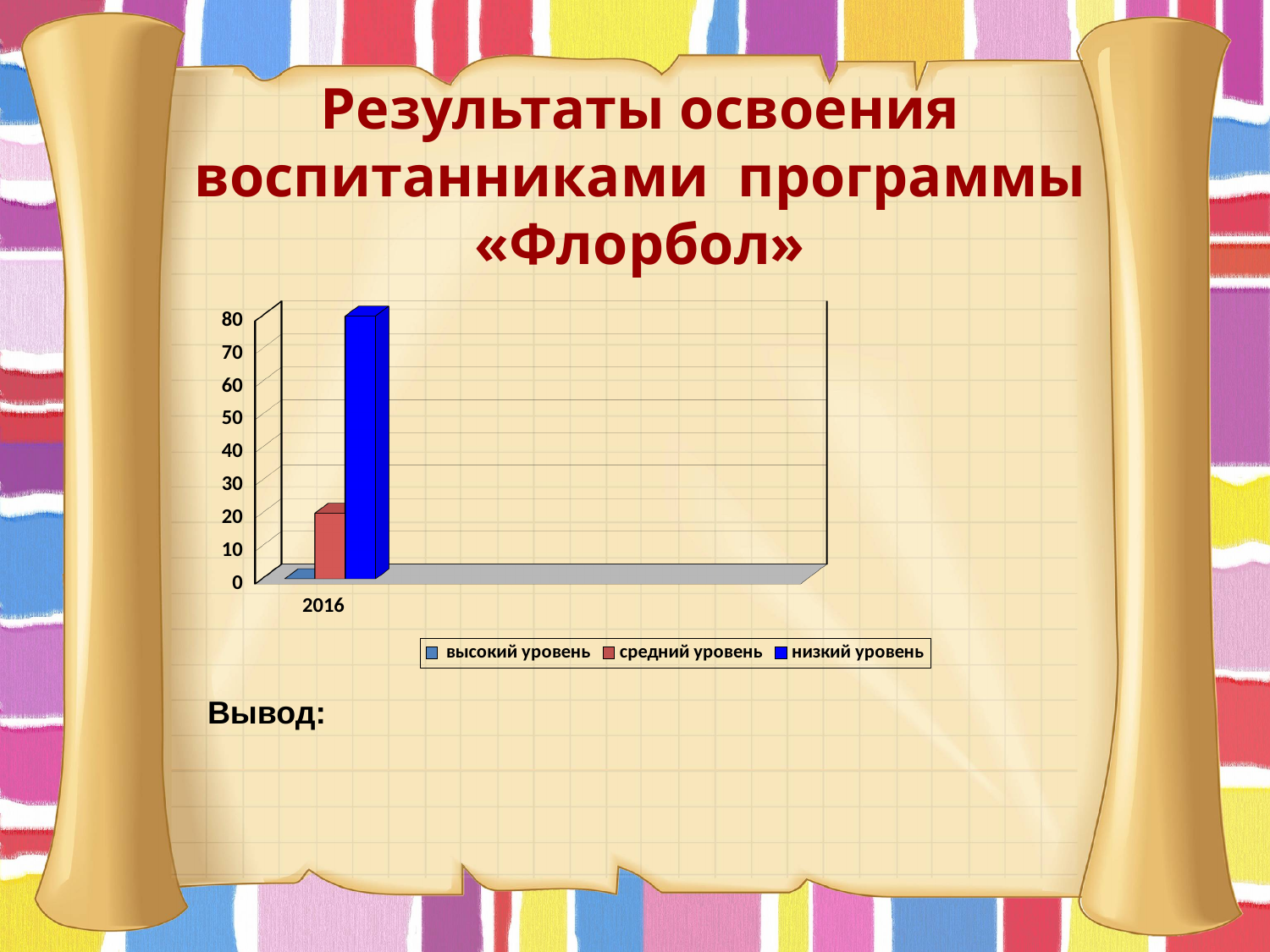
How many categories are shown on the x axis of the chart? 1 Which series has the lowest value in the chart? высокий уровень Is the value for низкий уровень greater or less than 70? greater How many series does the chart legend list? 3 What colour represents the series низкий уровень in the chart legend? blue Which is larger in the chart, the value for средний уровень or the value for высокий уровень? средний уровень Is the value for высокий уровень greater or less than 10? less Which category label appears on the x axis of the chart? 2016 Which series has the highest value in the chart? низкий уровень What kind of chart is shown on the slide? bar chart Which is larger in the chart, the value for низкий уровень or the value for средний уровень? низкий уровень Is the value for средний уровень greater or less than 30? less